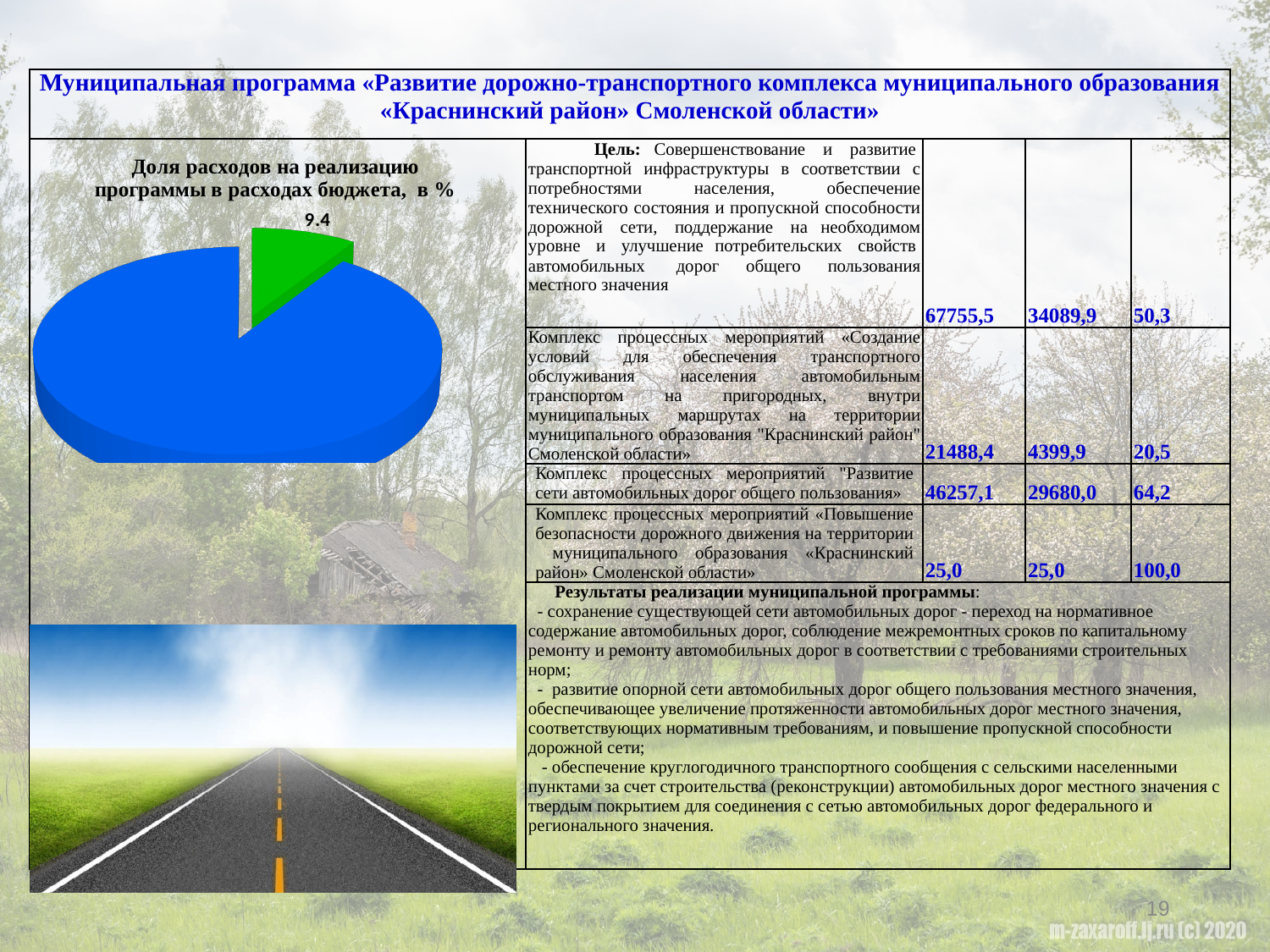
What share of the budget expenditures does the green slice represent, according to the label on the pie chart? 9.4 How many slices does the pie chart have? 2 Which slice of the pie chart is the smallest? the green slice What kind of chart is shown on the slide? pie chart What is the title of the pie chart? Доля расходов на реализацию программы в расходах бюджета, в % Which slice is larger in the pie chart, the blue one or the green one? the blue one What colour is the slice that carries the data label 9.4? green Which slice of the pie chart is the largest? the blue slice What value is printed on the green slice of the pie chart? 9.4